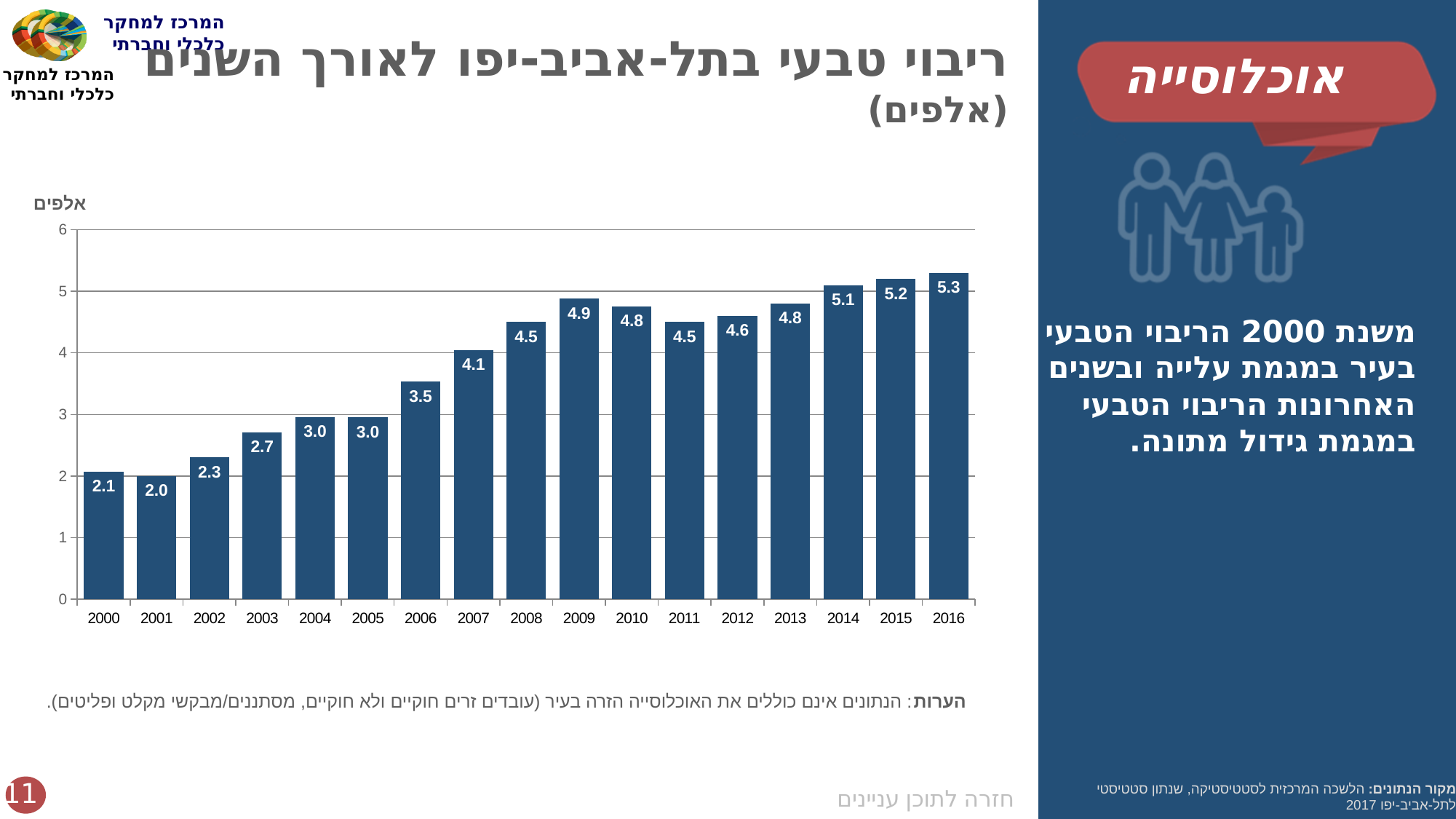
What is the label on the vertical axis of the chart? אלפים What type of chart is shown on the slide? Bar chart How many years are shown on the x axis? 17 What is the value for 2016? 5.3 What is the value for 2009? 4.9 Is the value for 2007 greater or less than 4? greater Do the values generally rise or fall from 2000 to 2016? Rise Which is larger, the value for 2009 or the value for 2010? 2009 What is the difference between the values for 2016 and 2000? 3.2 What is the value for 2000? 2.1 Which year has the lowest value? 2001 Which year has the highest value? 2016